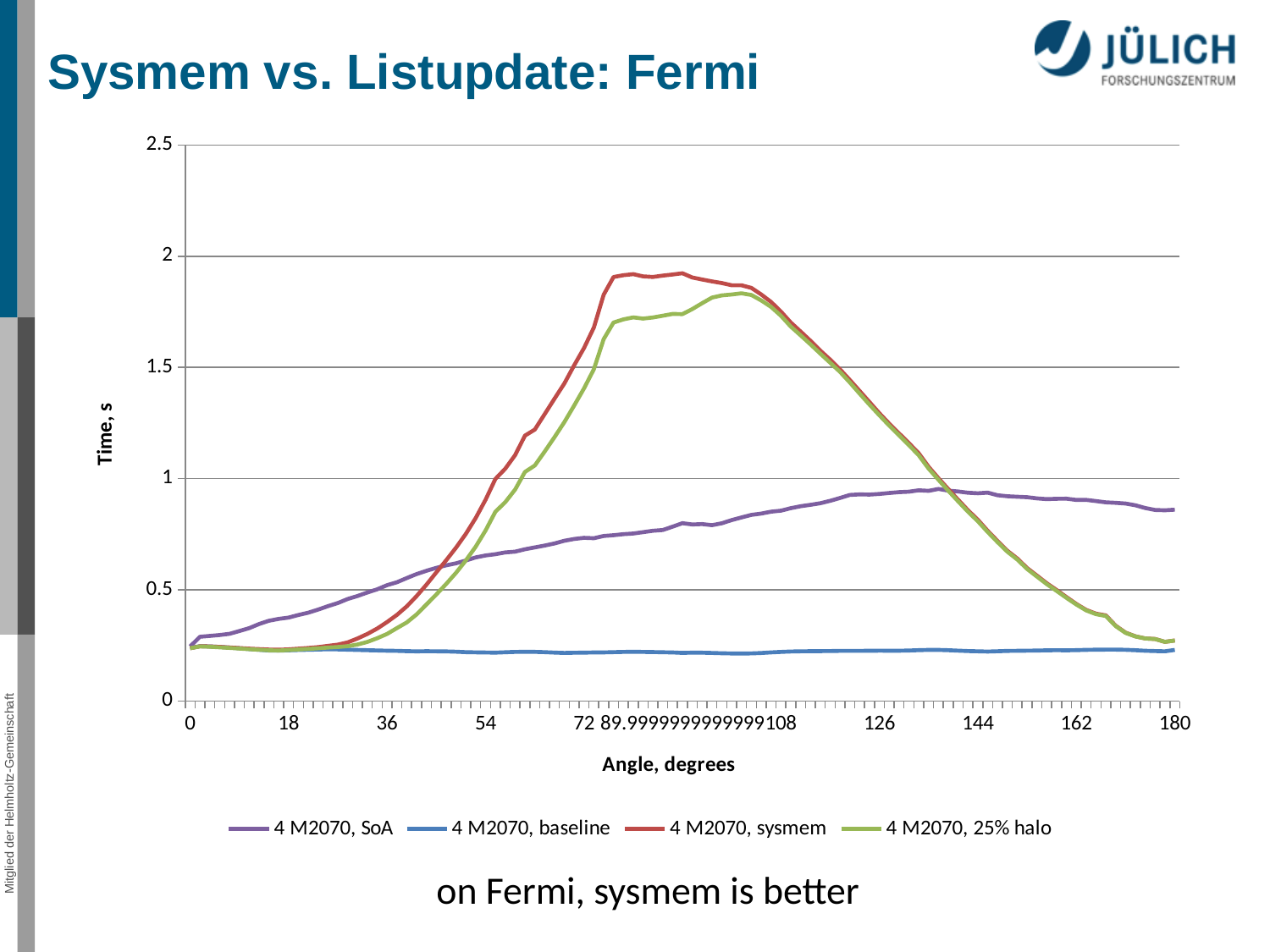
At 90 degrees, which series has the larger value: '4 M2070, sysmem' or '4 M2070, baseline'? 4 M2070, sysmem What kind of chart is shown on the slide? line chart Is the value for '4 M2070, SoA' at 126 degrees greater or less than 1? less Is the value for '4 M2070, sysmem' at 90 degrees greater or less than 1.5? greater Is the value for '4 M2070, 25% halo' at 180 degrees greater or less than 0.5? less At 36 degrees, which series has the larger value: '4 M2070, SoA' or '4 M2070, sysmem'? 4 M2070, SoA Which series stays lowest across the whole angle range? 4 M2070, baseline What is the label of the y axis? Time, s Which series reaches the highest peak value on the chart? 4 M2070, sysmem What is the label of the x axis? Angle, degrees How many series does the legend list? 4